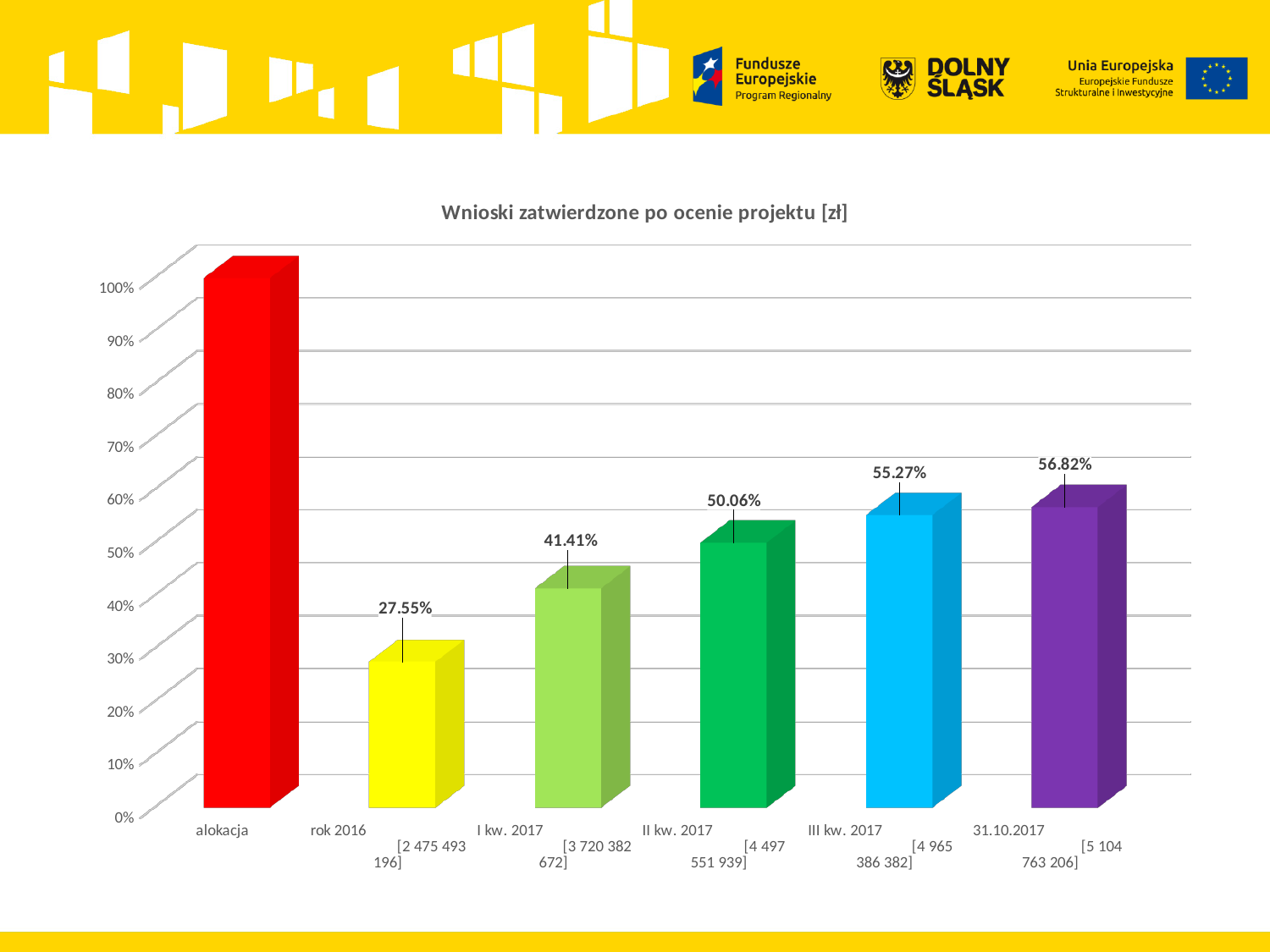
What is the value shown for III kw. 2017? 55.27% What is the difference between the values for I kw. 2017 and rok 2016? 13.86% Which is larger, the value for II kw. 2017 or the value for I kw. 2017? II kw. 2017 What is the value shown for rok 2016? 27.55% What is the value shown for II kw. 2017? 50.06% What is the value shown for 31.10.2017? 56.82% Which category has the lowest value? rok 2016 Do the values rise or fall from rok 2016 to 31.10.2017? rise How many bars are shown in the chart? 6 Which category has the highest value? alokacja What is the difference between the values for 31.10.2017 and III kw. 2017? 1.55% Is the value for alokacja greater or less than 90%? greater